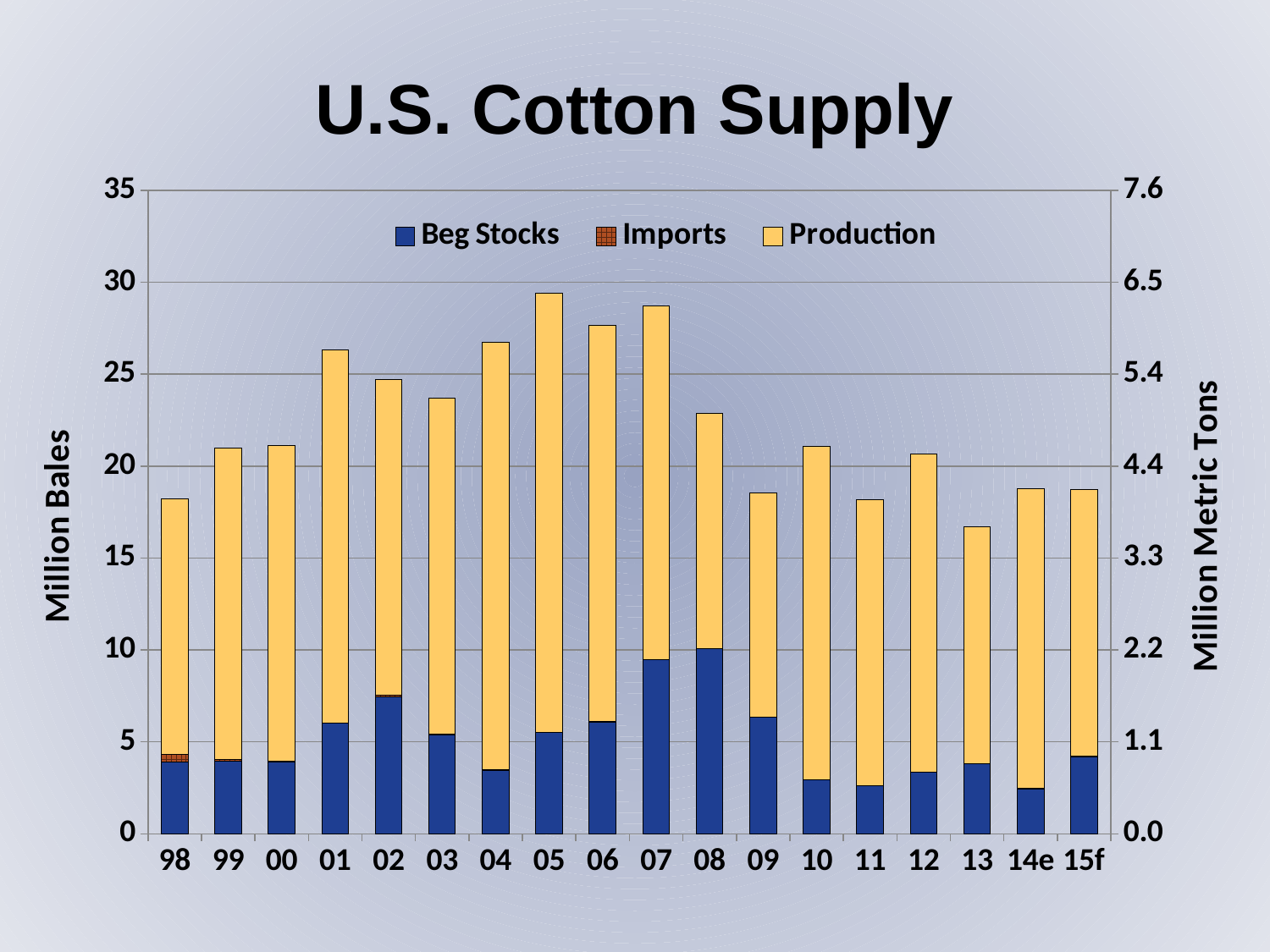
Which year has the largest Beg Stocks segment? 08 Is the Beg Stocks value for 08 greater or less than 5 million bales? greater What is the title of the left vertical axis? Million Bales How many years (categories) are shown along the x axis? 18 Which year has the highest total bar? 05 Do the total bar heights rise or fall from 98 to 01? rise Which year has the lowest total bar? 13 How many series does the legend list? 3 Which year has the larger total bar, 01 or 02? 01 Is the total bar for 05 greater or less than 25 million bales? greater Is the total bar for 13 greater or less than 20 million bales? less What kind of chart is shown on the slide? Stacked bar chart